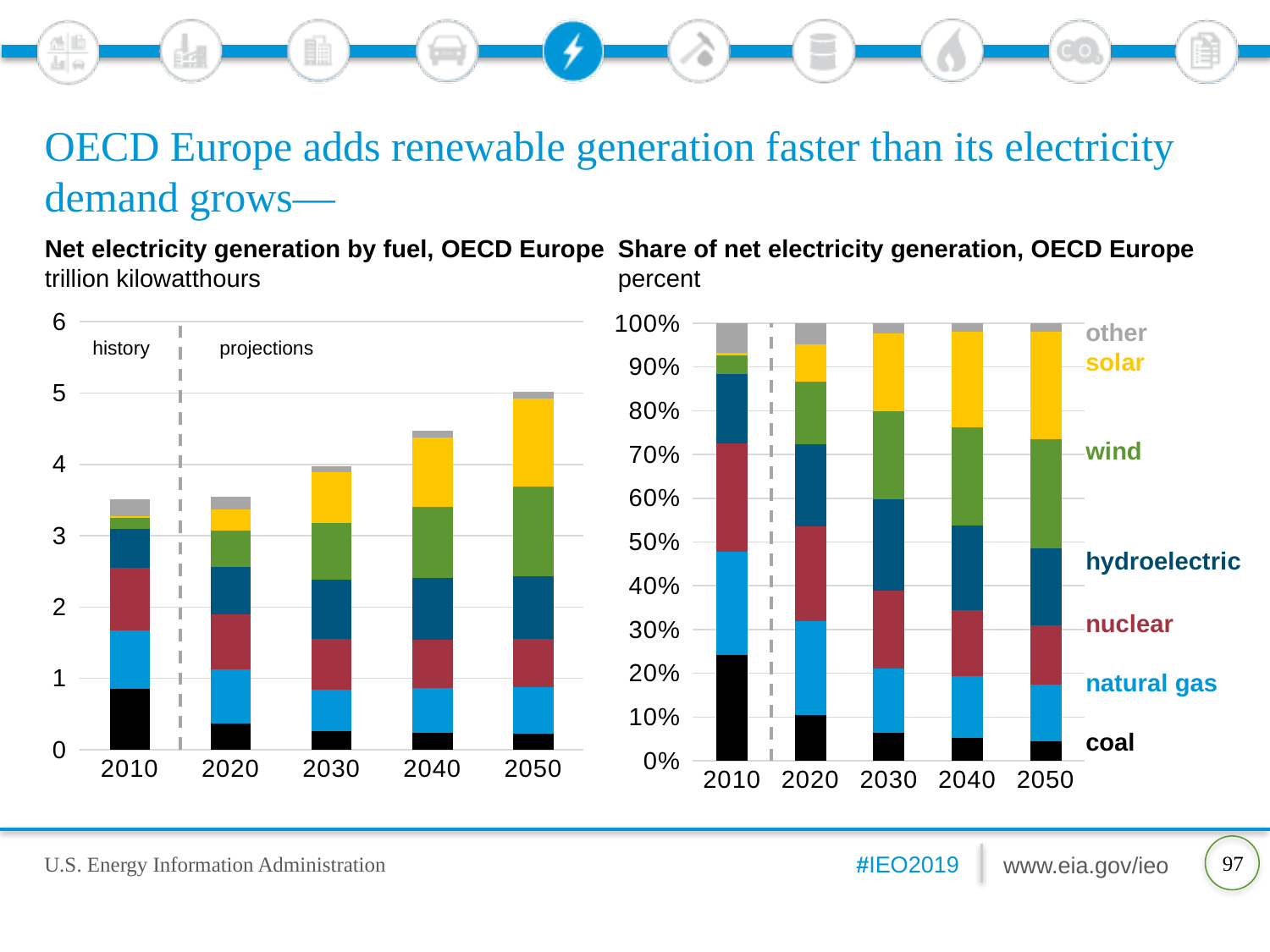
In the left chart, 'Net electricity generation by fuel, OECD Europe', does total net electricity generation rise or fall from 2010 to 2050? rise What kind of chart is the left chart, 'Net electricity generation by fuel, OECD Europe'? stacked bar chart In the right chart, 'Share of net electricity generation, OECD Europe', which is larger: the solar share in 2010 or the solar share in 2050? 2050 In the right chart, 'Share of net electricity generation, OECD Europe', is the coal share in 2050 greater or less than 10%? less In the left chart, 'Net electricity generation by fuel, OECD Europe', is the total generation for 2050 greater or less than 4 trillion kilowatthours? greater In the right chart, 'Share of net electricity generation, OECD Europe', does the coal share rise or fall from 2010 to 2050? fall How many fuel series does the legend of the right chart, 'Share of net electricity generation, OECD Europe', list? 7 In the right chart, 'Share of net electricity generation, OECD Europe', what colour represents coal? black In the right chart, 'Share of net electricity generation, OECD Europe', is the coal share in 2010 greater or less than 20%? greater How many years are shown on the x axis of the left chart, 'Net electricity generation by fuel, OECD Europe'? 5 In the left chart, 'Net electricity generation by fuel, OECD Europe', which year has the highest total net electricity generation? 2050